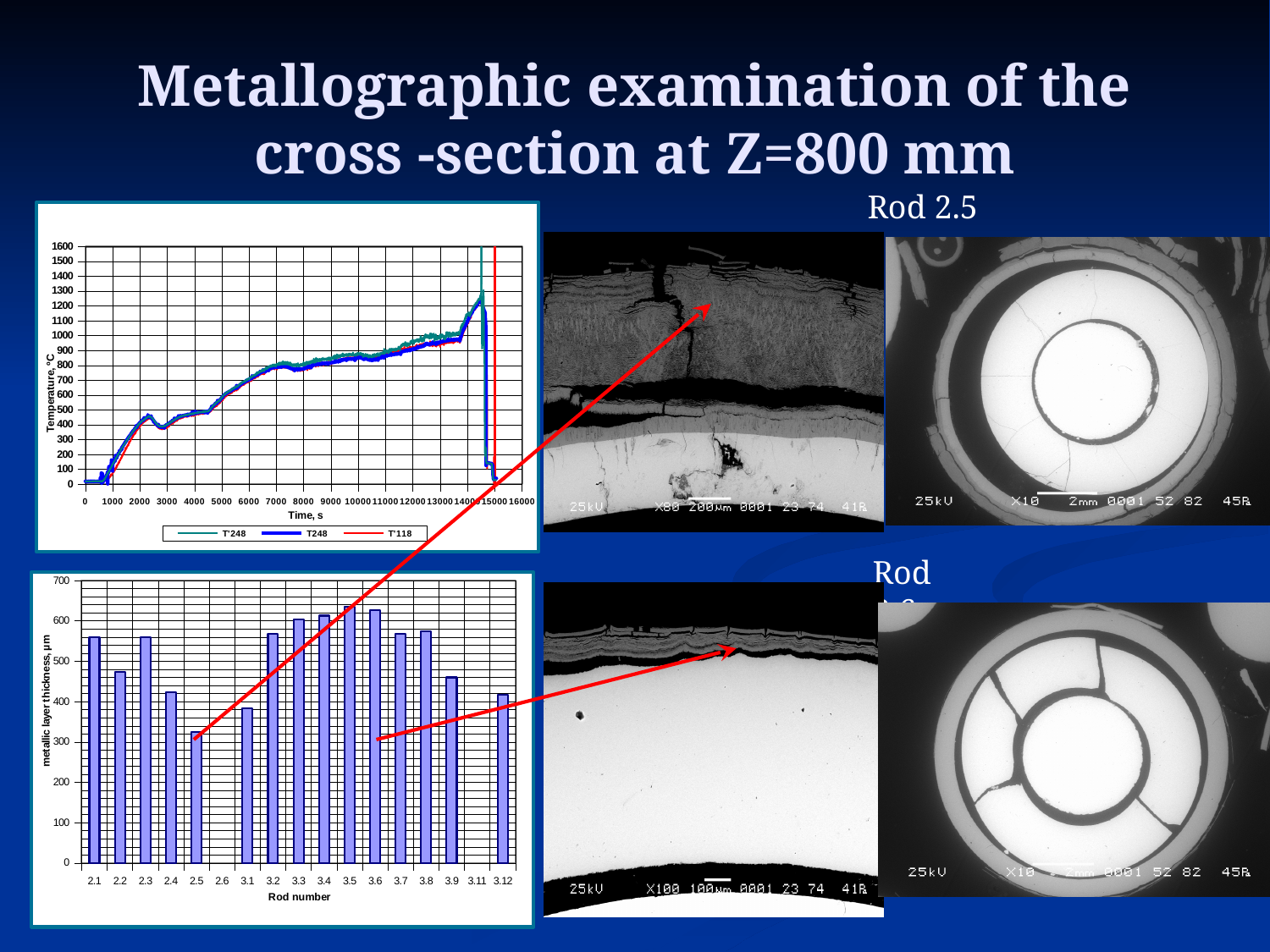
In the bottom-left bar chart, is the value for rod 3.9 greater or less than 500? less In the bottom-left bar chart, which is larger, the value for rod 2.1 or rod 2.5? 2.1 What kind of chart is the top-left chart of temperature against time? line chart In the bottom-left bar chart, which rod number has the lowest plotted metallic layer thickness? 2.5 What kind of chart is the bottom-left chart with rod numbers on the x axis? bar chart In the bottom-left bar chart, is the value for rod 2.5 greater or less than 400? less In the bottom-left bar chart, is the value for rod 3.3 greater or less than 500? greater How many rod numbers are labelled on the x axis of the bottom-left bar chart? 17 How many series does the legend of the top-left temperature chart list? 3 What are the legend entries of the top-left temperature chart? T'248, T248, T'118 What is the y-axis title of the bottom-left bar chart? metallic layer thickness, µm